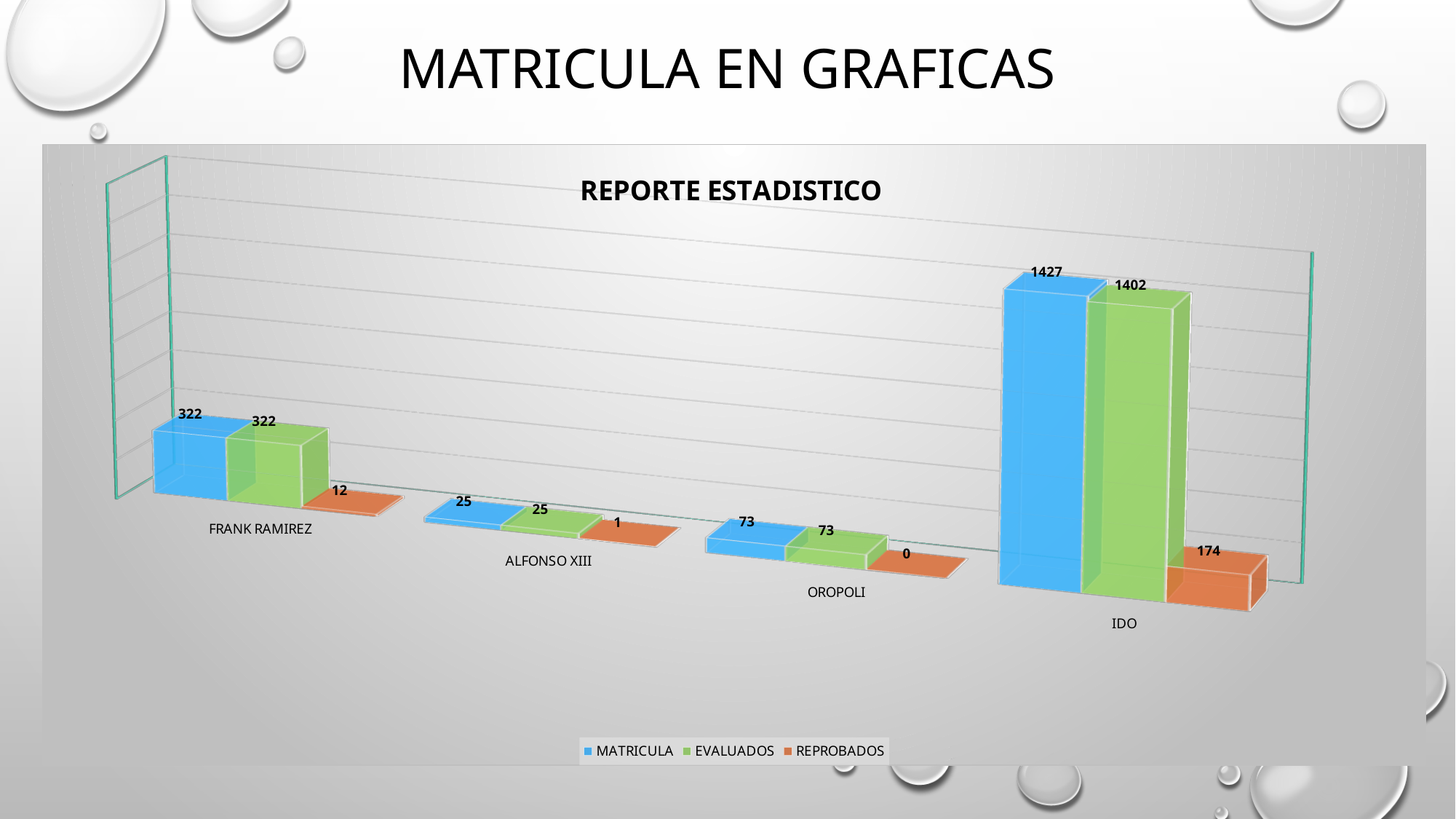
Which category has the lowest MATRICULA value? ALFONSO XIII What is the REPROBADOS value for ALFONSO XIII? 1 How many categories are shown on the x axis? 4 Which category has the highest MATRICULA value? IDO What kind of chart is shown? bar chart What is the REPROBADOS value for OROPOLI? 0 Which is larger, the REPROBADOS value for IDO or the REPROBADOS value for FRANK RAMIREZ? IDO What is the MATRICULA value for IDO? 1427 What is the EVALUADOS value for FRANK RAMIREZ? 322 What is the difference between the MATRICULA and EVALUADOS values for IDO? 25 What is the title of the chart? REPORTE ESTADISTICO How many series does the legend list? 3